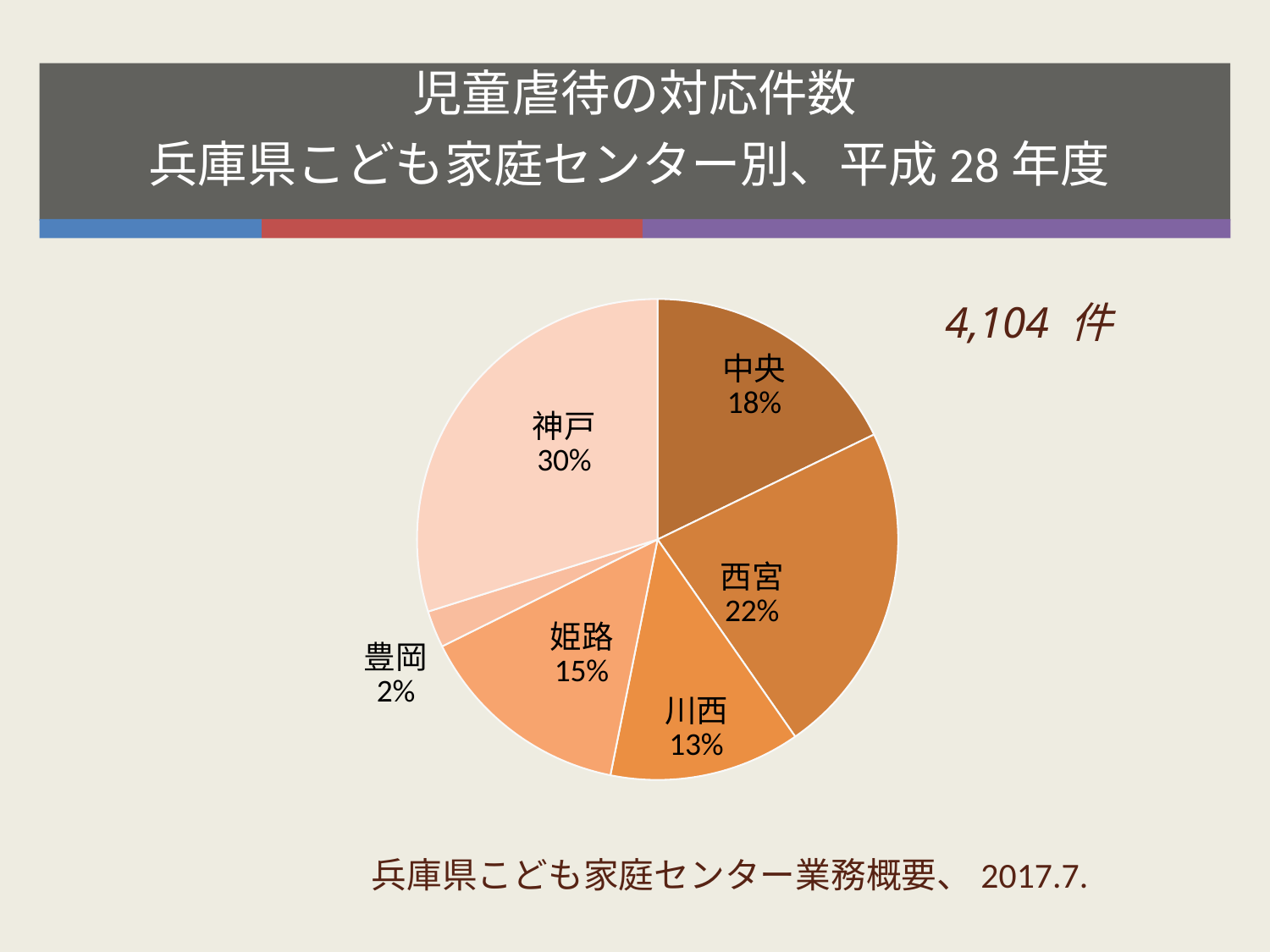
How many slices does the pie chart have? 6 What share of the pie does 中央 account for? 18% What is the difference in percentage points between 神戸 and 姫路? 15 What share of the pie does 川西 account for? 13% What share of the pie does 西宮 account for? 22% Which center has the largest slice of the pie? 神戸 Which center has the smallest slice of the pie? 豊岡 What total number of cases is printed next to the pie chart? 4,104 件 Which is larger, the share for 西宮 or the share for 中央? 西宮 What kind of chart is shown on the slide? pie chart